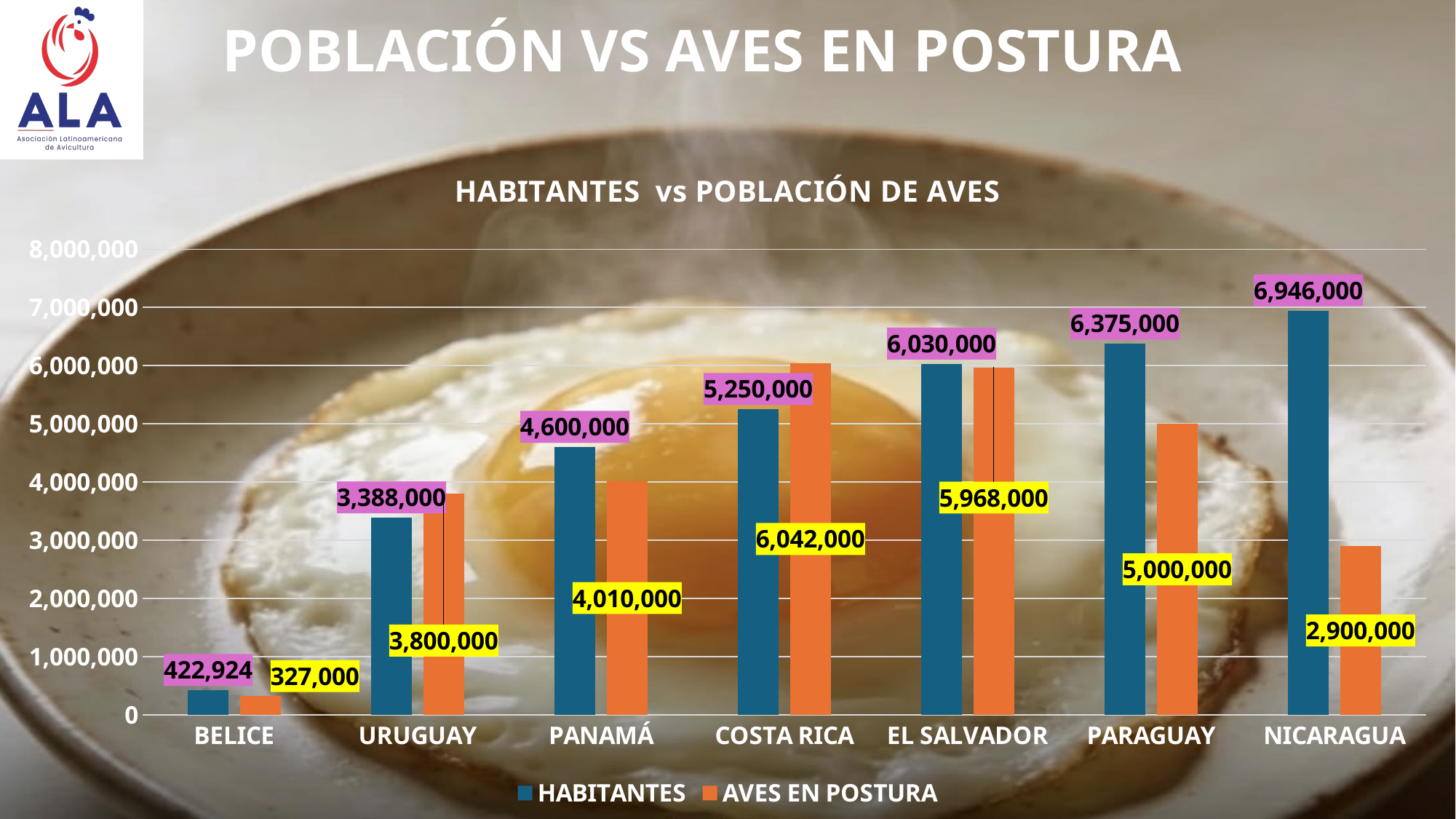
What is the HABITANTES value for BELICE? 422,924 Which country has the highest HABITANTES value? NICARAGUA How many series does the legend list? 2 What is the title of the chart? HABITANTES vs POBLACIÓN DE AVES What is the HABITANTES value for NICARAGUA? 6,946,000 What is the difference between HABITANTES and AVES EN POSTURA for NICARAGUA? 4,046,000 Is the AVES EN POSTURA value for PARAGUAY greater or less than 6,000,000? less Which country has the lowest AVES EN POSTURA value? BELICE What kind of chart is shown on the slide? bar chart For URUGUAY, which is larger: HABITANTES or AVES EN POSTURA? AVES EN POSTURA What is the AVES EN POSTURA value for COSTA RICA? 6,042,000 How many countries are shown on the x axis? 7